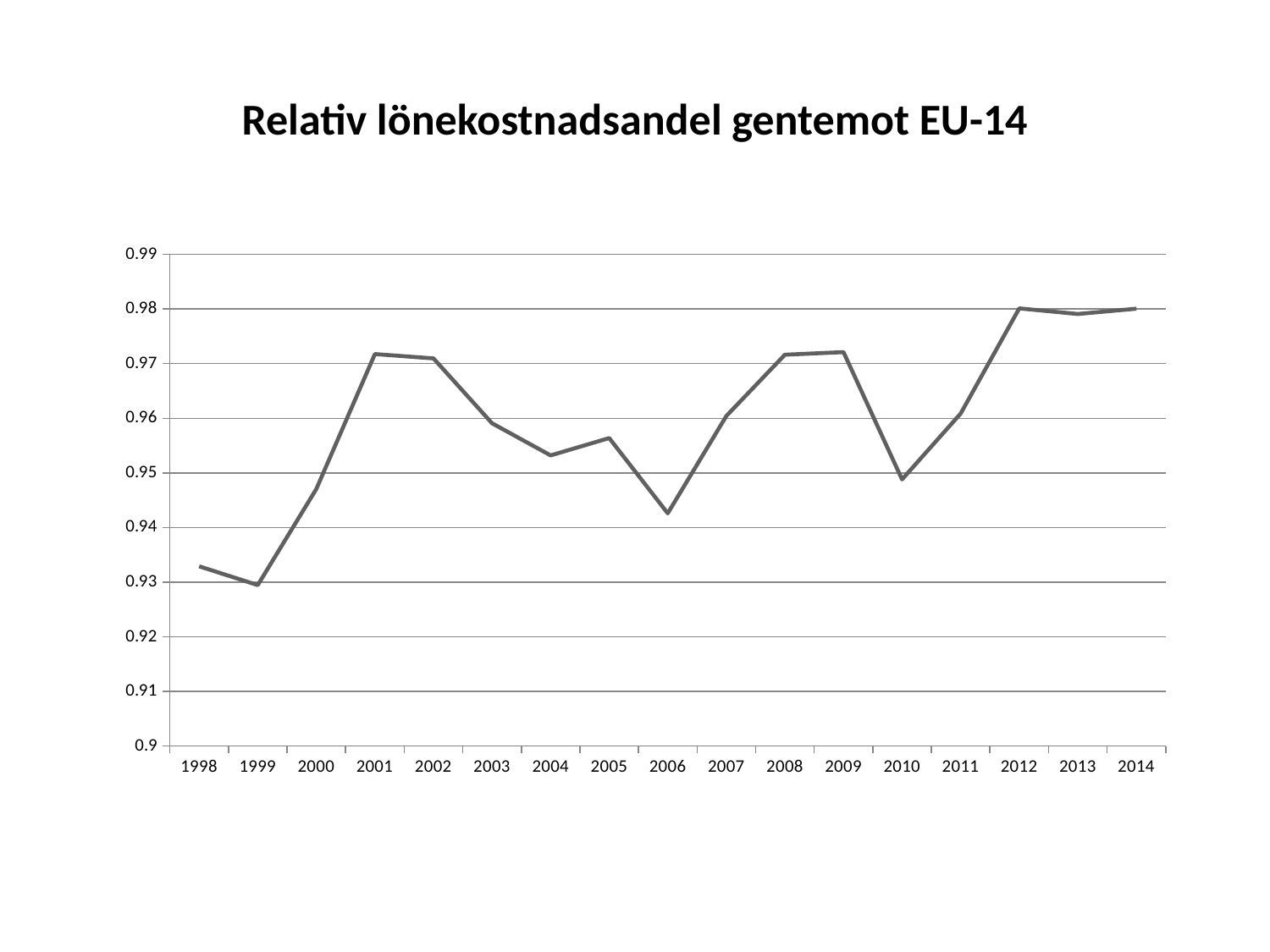
What is the title of the chart? Relativ lönekostnadsandel gentemot EU-14 What kind of chart is shown on the slide? line chart Is the value for 2006 greater or less than 0.95? less Which year has the larger value, 2010 or 2012? 2012 How many years are plotted along the x axis? 17 Which year has the lowest value on the chart? 1999 Is the value for 2008 greater or less than 0.96? greater Which year has the larger value, 2001 or 2006? 2001 Does the value rise or fall from 1999 to 2001? rise Is the value for 2012 greater or less than 0.97? greater